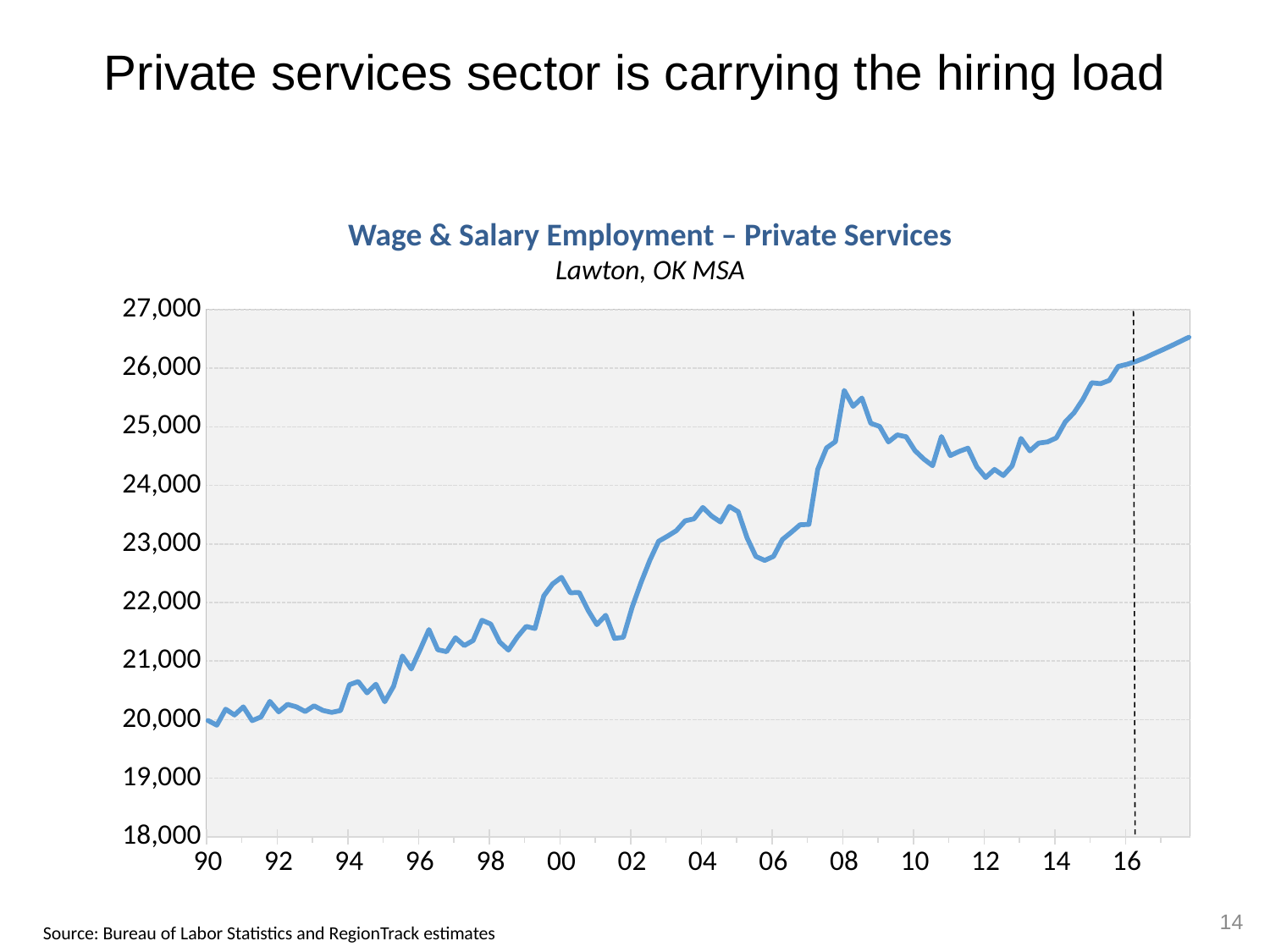
Which metropolitan area does the chart cover, according to its subtitle? Lawton, OK MSA Which is higher: the value at the start of 2008 or the value at the start of 2006? 2008 Is the value at the end of the series (after 2016) greater or less than 26,000? greater Overall, do the values rise or fall from 1990 to the end of the series? rise Is the value at the start of 2014 greater or less than 25,000? less Is the value at the start of 2004 greater or less than 23,000? greater What kind of chart is shown on the slide? line chart What is the title of the chart? Wage & Salary Employment – Private Services